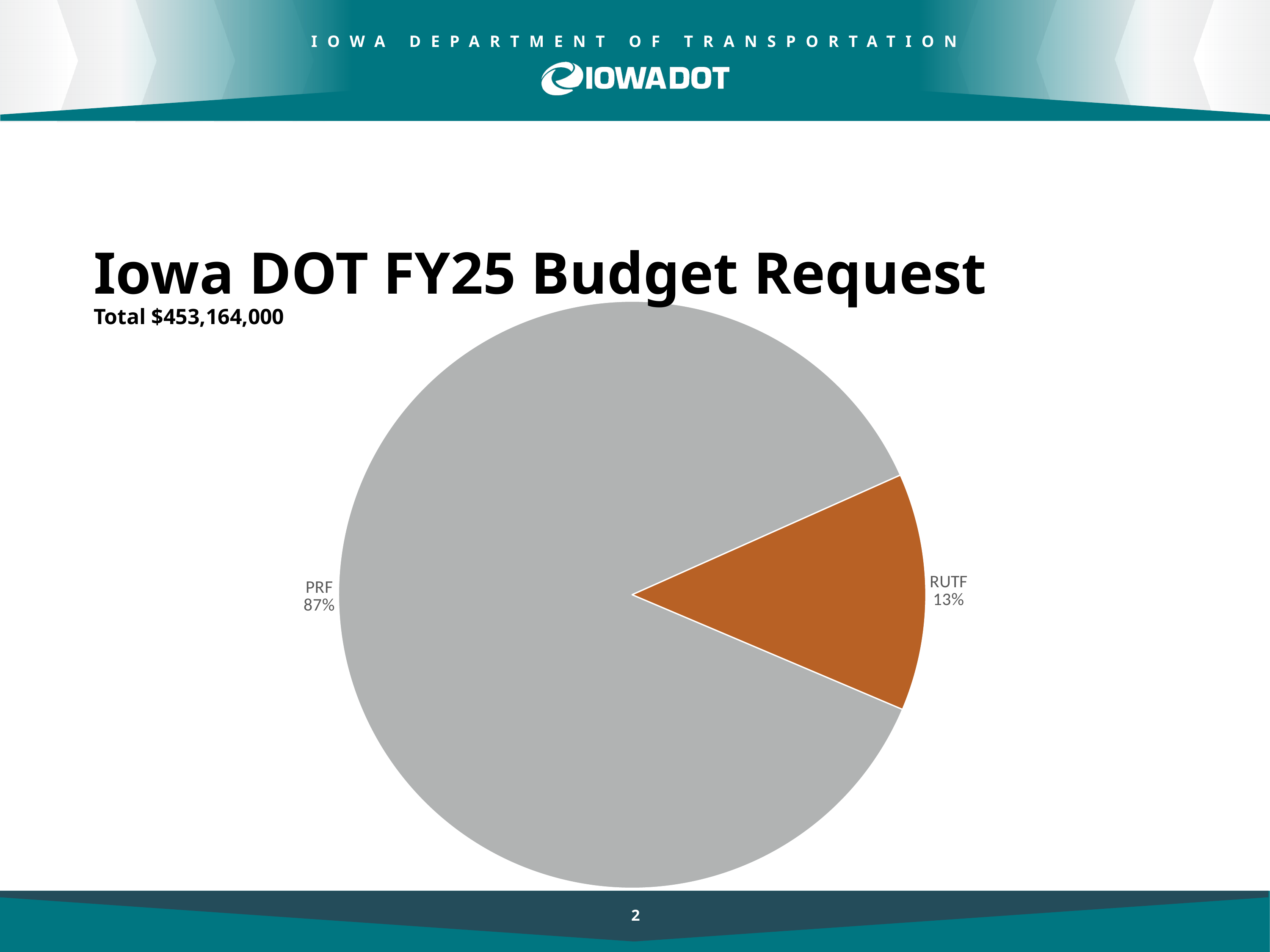
What share of the pie does RUTF represent? 13% How many slices does the pie chart have? 2 Which is larger, the PRF slice or the RUTF slice? PRF What kind of chart is shown on the slide? pie chart What total amount is stated for the FY25 budget request? $453,164,000 What colour is the RUTF slice? orange Which slice of the pie is the smallest? RUTF Which slice of the pie is the largest? PRF What share of the pie does PRF represent? 87% What is the title of the chart? Iowa DOT FY25 Budget Request What is the difference in percentage points between the PRF share and the RUTF share? 74